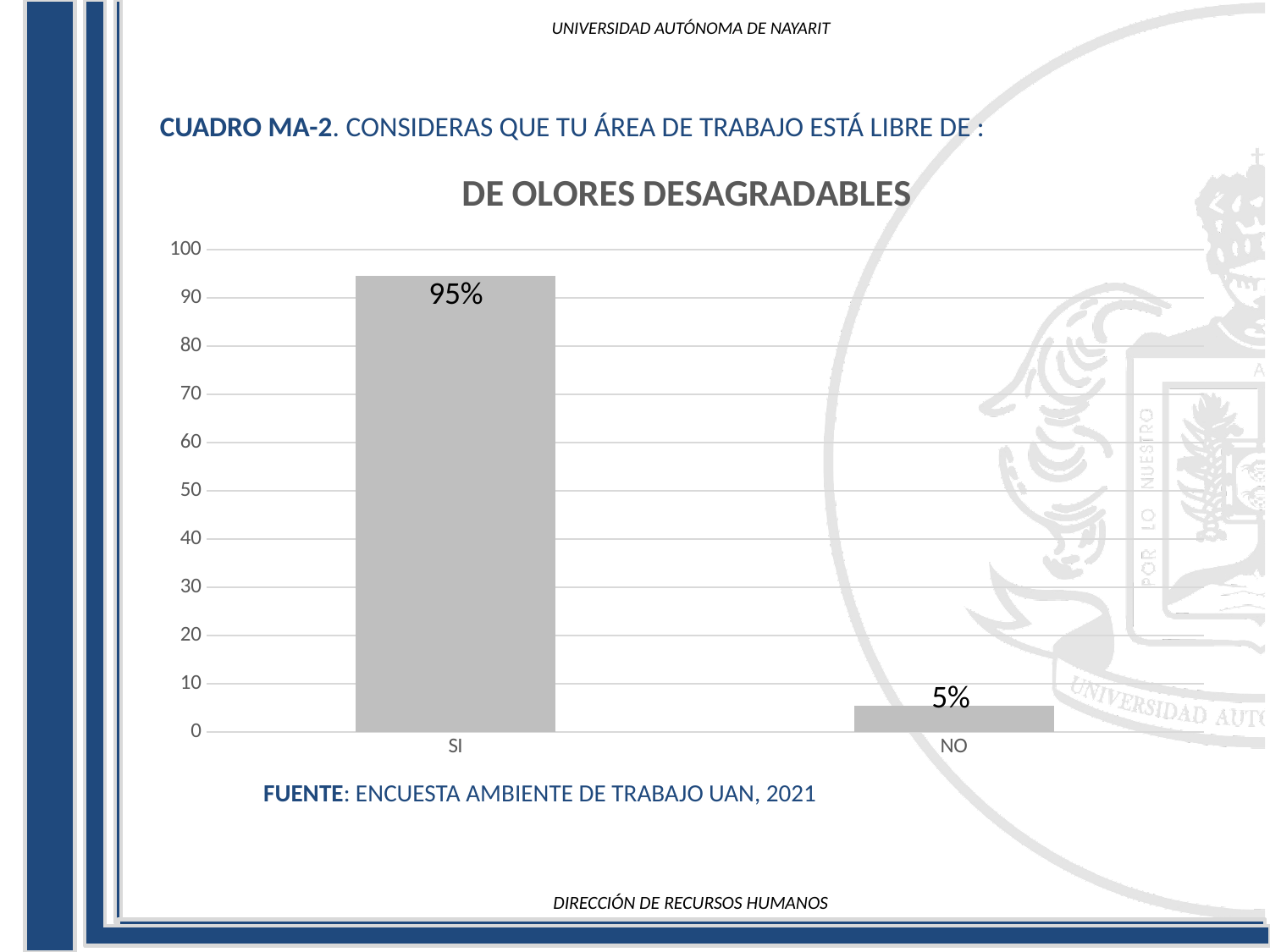
Is the value for NO greater or less than 10? less Which category has the highest value? SI What is the title of the chart? DE OLORES DESAGRADABLES What is the difference between the values for SI and NO? 90% What is the value for NO? 5% How many categories are shown on the x axis? 2 What is the source cited below the chart? ENCUESTA AMBIENTE DE TRABAJO UAN, 2021 Is the value for SI greater or less than 90? greater What kind of chart is shown? bar chart Which category has the lowest value? NO What is the value for SI? 95% Which is larger, the value for SI or the value for NO? SI